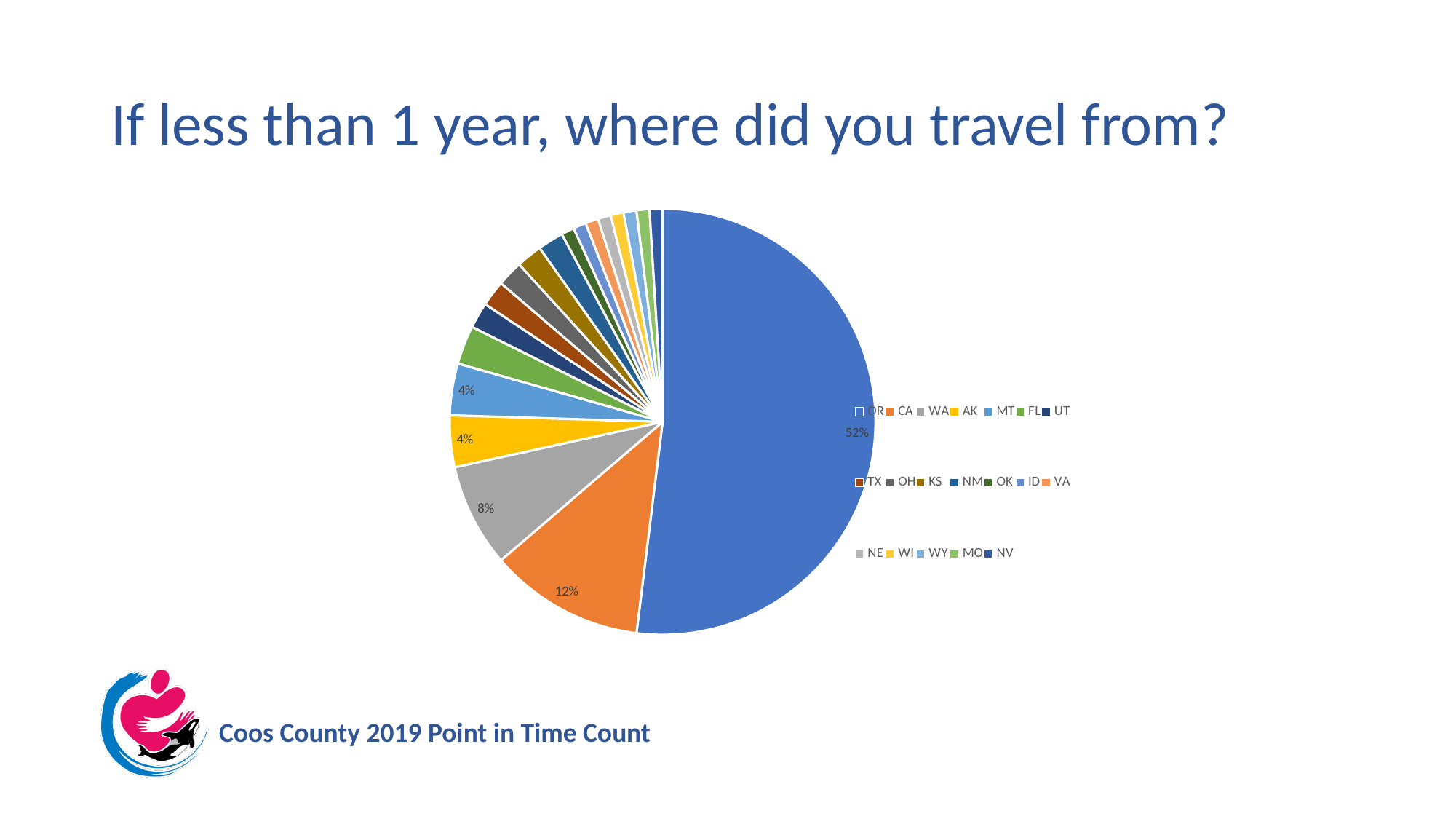
What share of the pie does AK account for? 4% Which state has the largest slice of the pie? OR What is the title of the slide containing the chart? If less than 1 year, where did you travel from? What kind of chart is shown on the slide? pie chart How many states are listed in the legend? 19 What is the difference in percentage points between the CA slice and the WA slice? 4 What share of the pie does MT account for? 4% What share of the pie does OR account for? 52% What is the difference in percentage points between the OR slice and the CA slice? 40 Which is larger, the slice for CA or the slice for WA? CA